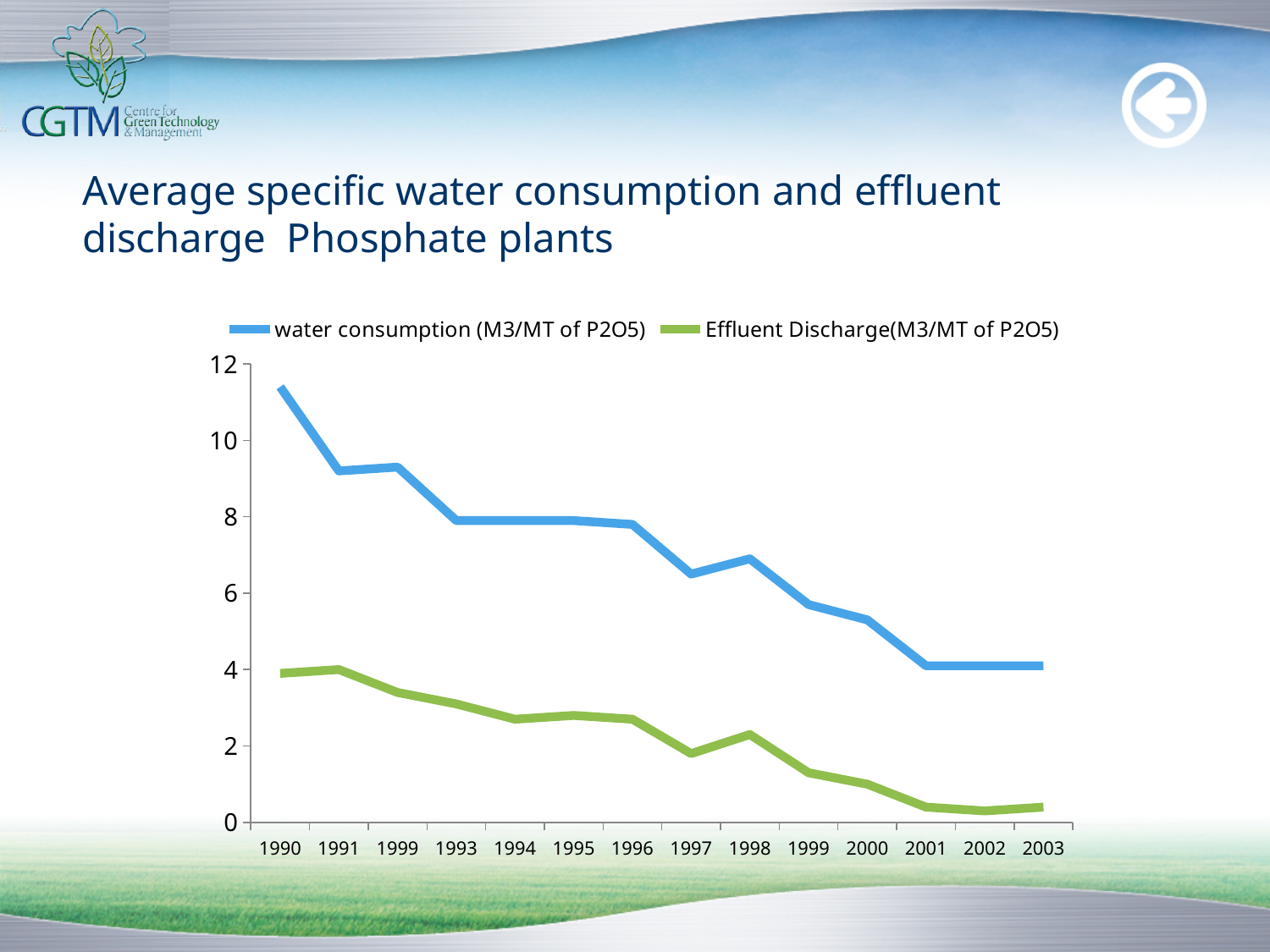
Is the value for water consumption in 2000 greater or less than 6? less Is the value for Effluent Discharge in 1994 greater or less than 2? greater Does water consumption generally rise or fall from 1990 to 2003? fall Is the value for Effluent Discharge in 2002 greater or less than 2? less What kind of chart is shown on the slide? line chart In which year is water consumption (M3/MT of P2O5) highest? 1990 Which series has the larger value in 1990, water consumption or Effluent Discharge? water consumption Which colour is used for the Effluent Discharge line? green How many years are plotted along the x axis? 14 How many series does the legend list? 2